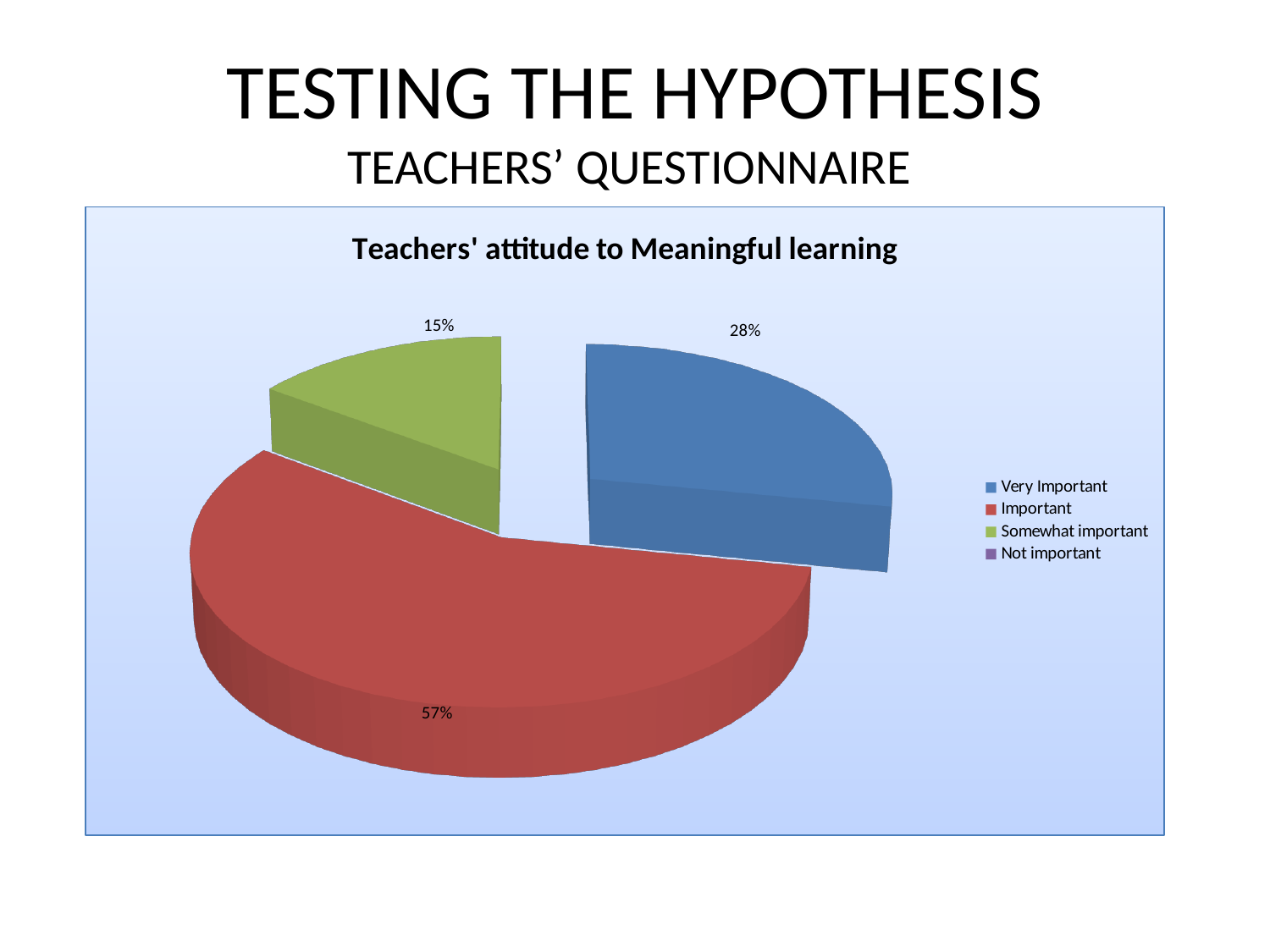
What is the difference in percentage points between the Important and Very Important slices? 29% What share of the pie is labelled for the Very Important slice? 28% How many categories does the legend list? 4 Which category has the largest slice of the pie? Important What share of the pie is labelled for the Important slice? 57% Which of the labelled slices is the smallest? Somewhat important Which slice is larger, Very Important or Somewhat important? Very Important What share of the pie is labelled for the Somewhat important slice? 15% Which colour represents the Important category in the legend? red What is the title of the chart? Teachers' attitude to Meaningful learning What kind of chart is shown on the slide? pie chart What is the difference in percentage points between the Very Important and Somewhat important slices? 13%